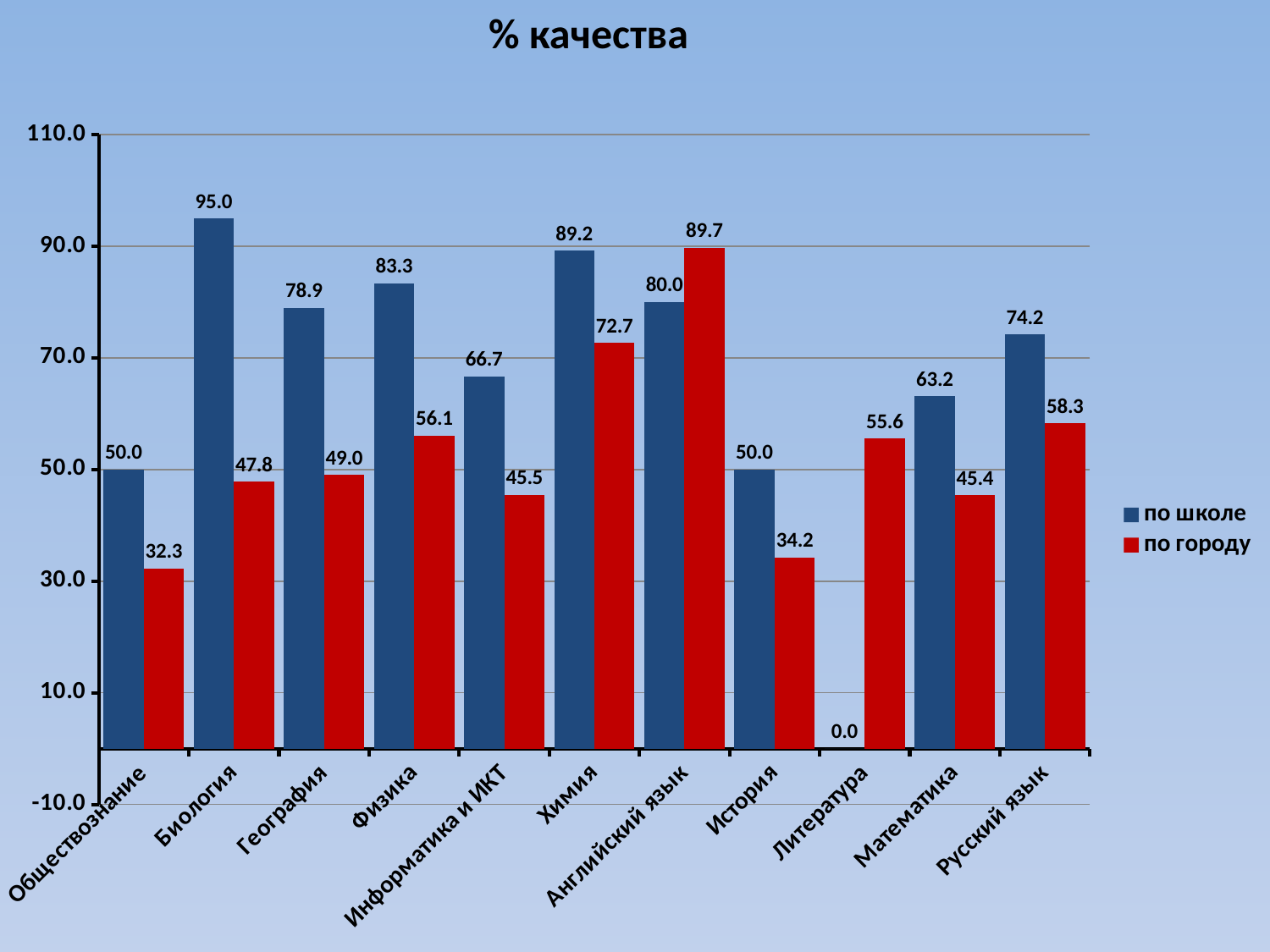
How many series does the legend list? 2 What is the difference between the по школе and по городу values for Физика? 27.2 Which colour represents the по городу series? red What is the value for Английский язык in the по городу series? 89.7 Which category has the highest value in the по школе series? Биология What is the value for Биология in the по школе series? 95.0 What is the value for Литература in the по школе series? 0.0 What kind of chart is shown on the slide? bar chart How many categories are shown on the x axis? 11 Which category has the lowest value in the по городу series? Обществознание What is the title of the chart? % качества Which is larger for Английский язык: the по школе value or the по городу value? по городу